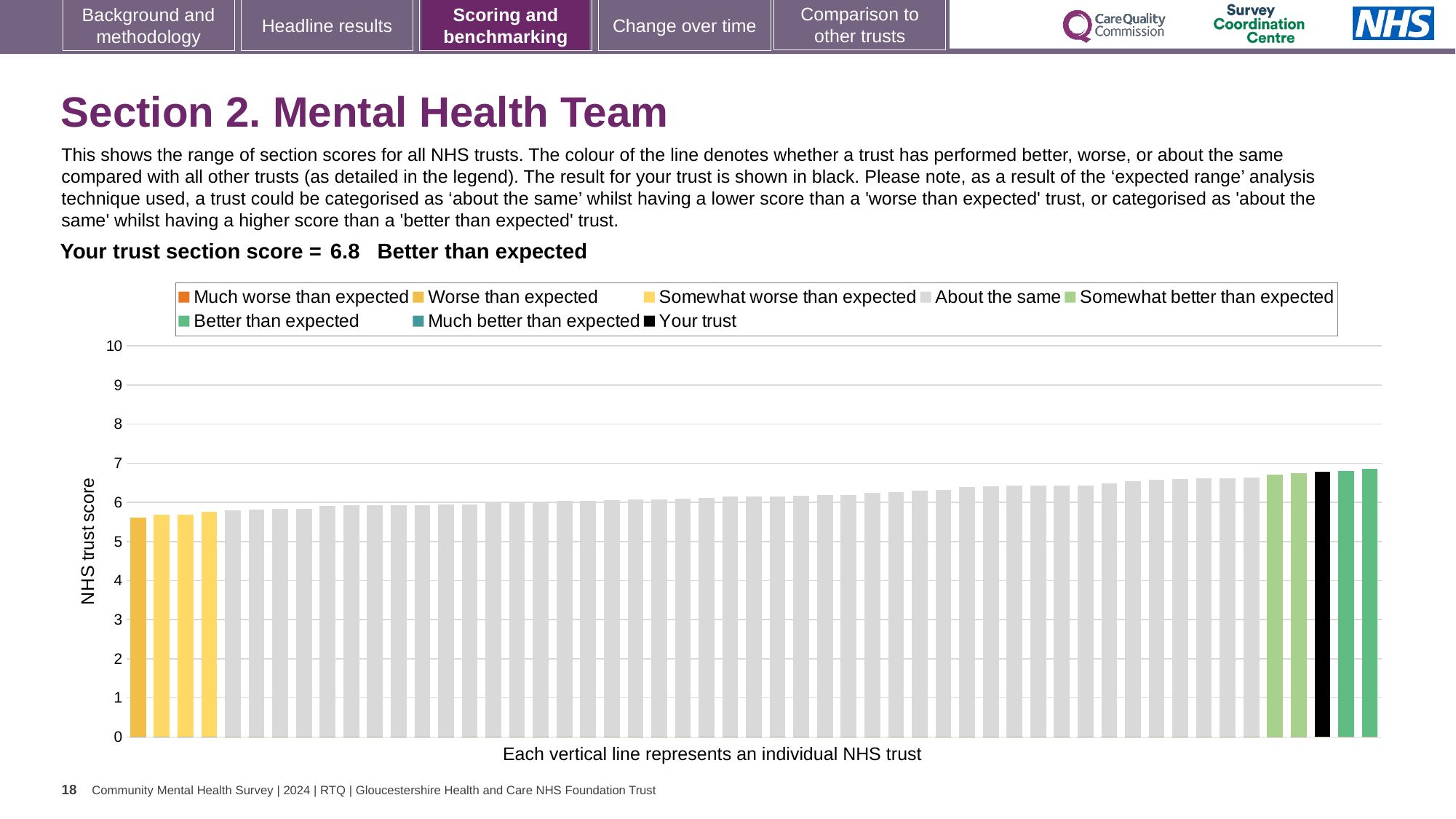
What colour is used for the bar representing your trust? Black What kind of chart is shown on the slide? Bar chart Do the bar values rise or fall from left to right along the x axis? Rise Which category is your trust placed in for this section? Better than expected Is the value for the leftmost bar greater or less than 6? less Is the value for the highest bar greater or less than 7? less How many entries does the chart legend list? 8 Which is larger: the value for your trust (black bar) or the value for the leftmost bar? Your trust Is the value for your trust (the black bar) greater or less than 6? greater What is the section score for your trust shown on the slide? 6.8 What is the title of the vertical axis? NHS trust score